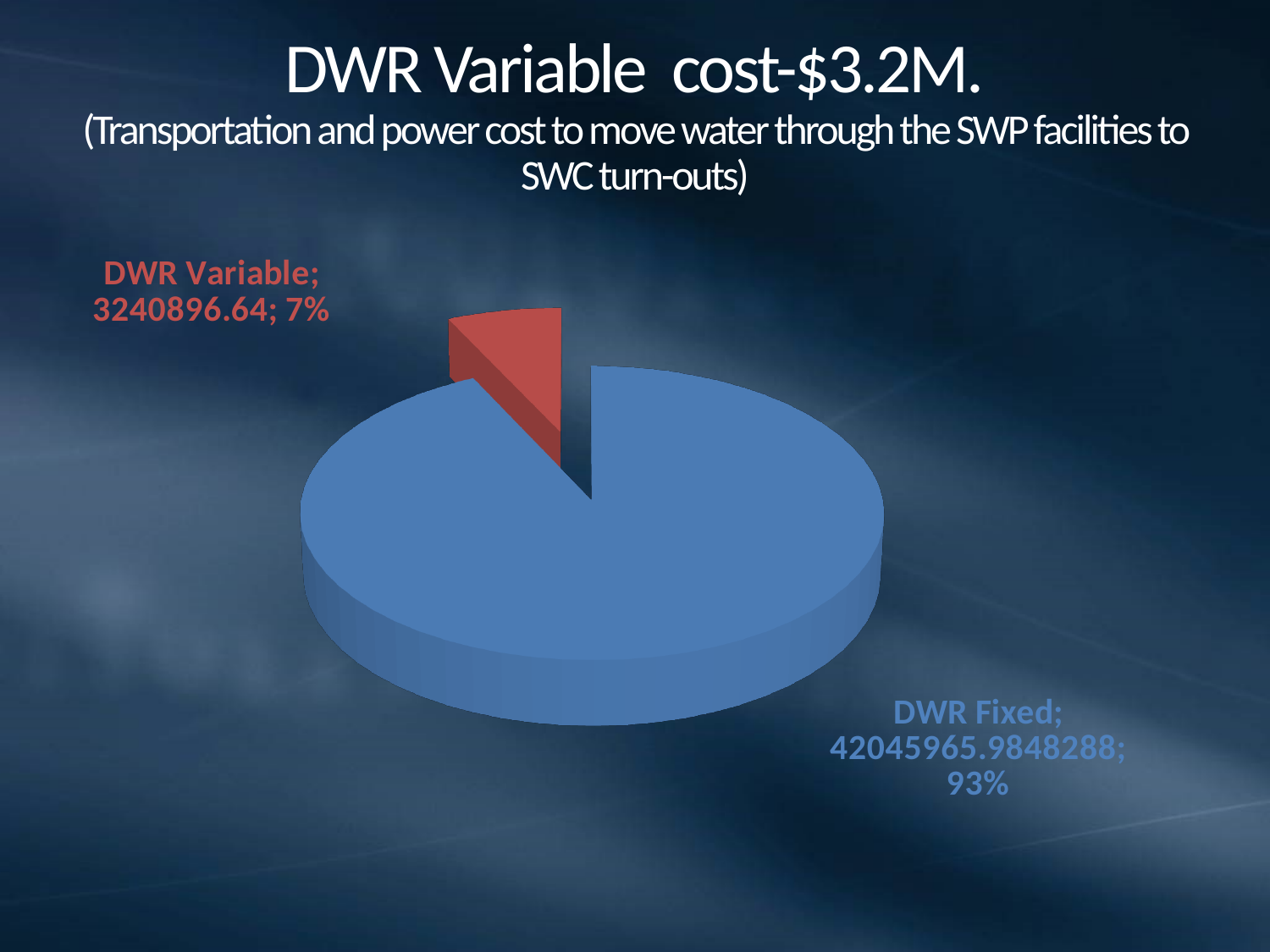
Which slice is the smallest? DWR Variable What is the value for DWR Variable? 3240896.64 What kind of chart is shown on the slide? pie chart Which slice is the largest? DWR Fixed What colour is the DWR Variable slice? red What is the value for DWR Fixed? 42045965.9848288 How many slices does the pie chart have? 2 Which is larger, DWR Fixed or DWR Variable? DWR Fixed What share of the pie does DWR Fixed represent? 93% What share of the pie does DWR Variable represent? 7% What is the title of the slide? DWR Variable cost-$3.2M.